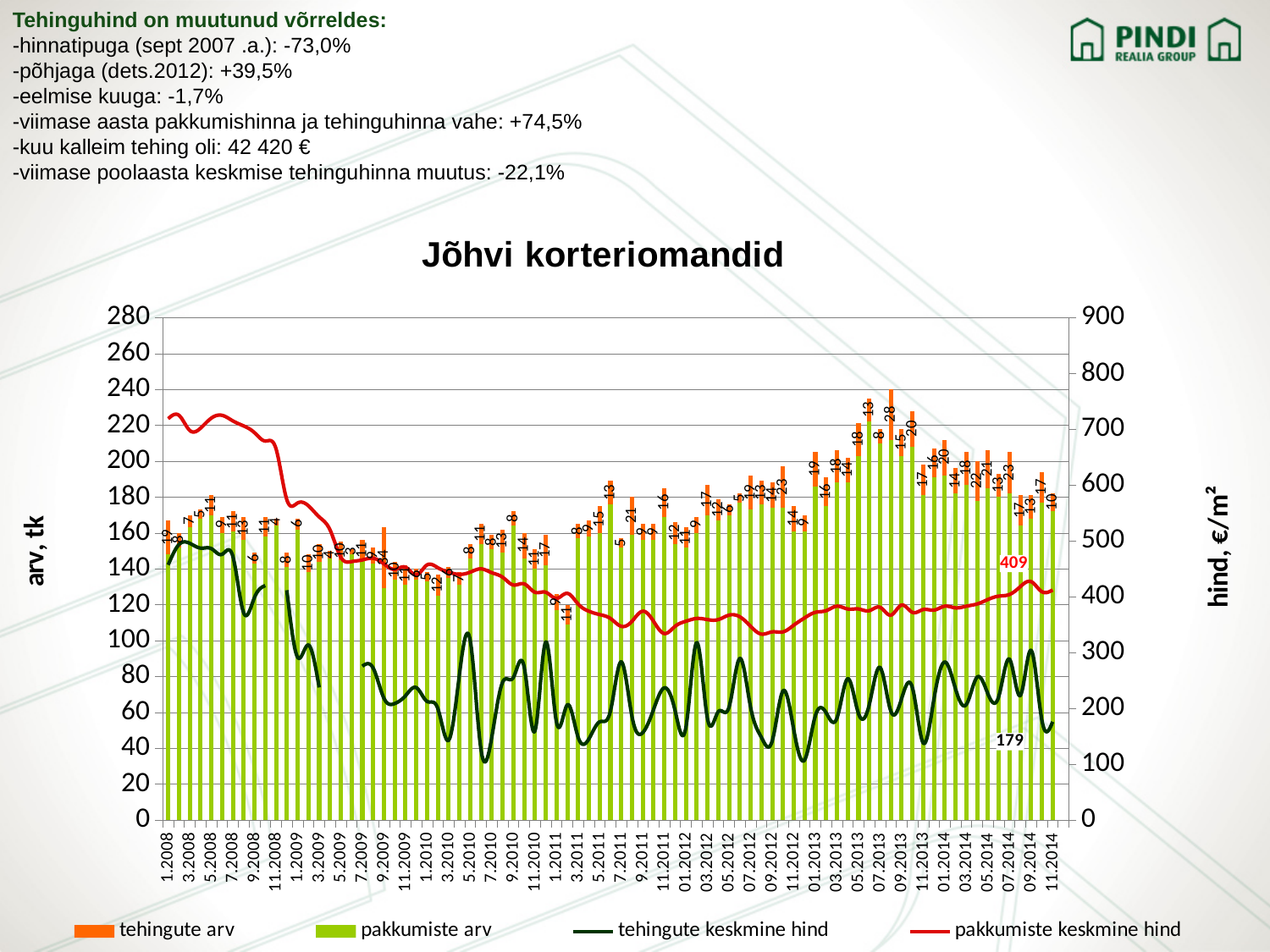
How many series does the chart legend list? 4 What is the title of the chart? Jõhvi korteriomandid Does the pakkumiste keskmine hind line rise or fall between 1.2008 and 1.2012? fall What kind of chart is shown on the slide? Combined bar and line chart Is the pakkumiste keskmine hind value at 1.2008 greater or less than 600? greater What is the labelled value of the tehingute keskmine hind line at the end of the series? 179 Is the tallest bar in the chart (around 7.2013) greater or less than 200 on the left axis? greater What colour is the pakkumiste keskmine hind line in the legend? Red What is the labelled value of the pakkumiste keskmine hind line at the end of the series? 409 Is the tehingute keskmine hind value at 5.2010 greater or less than 400? less At the end of the series, which is larger: pakkumiste keskmine hind (409) or tehingute keskmine hind (179)? pakkumiste keskmine hind What is the difference between the labelled pakkumiste keskmine hind (409) and tehingute keskmine hind (179) at the end of the series? 230